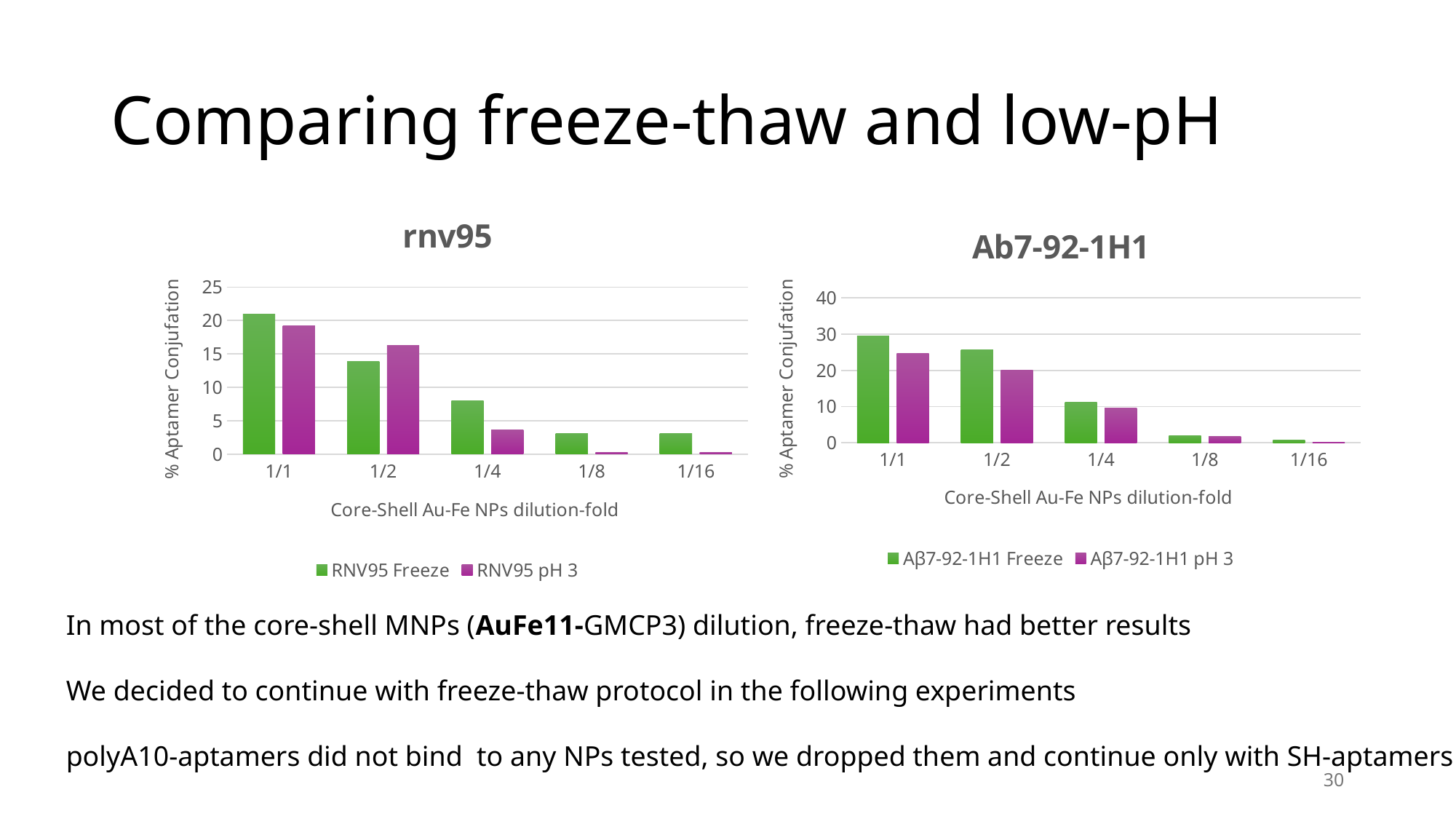
In the rnv95 chart, is the RNV95 Freeze value at 1/4 greater or less than 5? greater How many dilution-fold categories are shown on the x axis of the rnv95 chart? 5 What is the x-axis title of the rnv95 chart? Core-Shell Au-Fe NPs dilution-fold In the rnv95 chart, is the RNV95 Freeze value at 1/1 greater or less than 20? greater In the Ab7-92-1H1 chart, do the Aβ7-92-1H1 Freeze values rise or fall as the dilution-fold goes from 1/1 to 1/16? fall In the Ab7-92-1H1 chart, is the Aβ7-92-1H1 Freeze value at 1/8 greater or less than 10? less How many series does the legend of the Ab7-92-1H1 chart list? 2 In the rnv95 chart, at which dilution-fold is the RNV95 Freeze value highest? 1/1 What kind of chart is the rnv95 chart? bar chart In the Ab7-92-1H1 chart, at dilution-fold 1/1, which series has the larger value, Aβ7-92-1H1 Freeze or Aβ7-92-1H1 pH 3? Aβ7-92-1H1 Freeze In the rnv95 chart, at dilution-fold 1/2, which series has the larger value, RNV95 Freeze or RNV95 pH 3? RNV95 pH 3